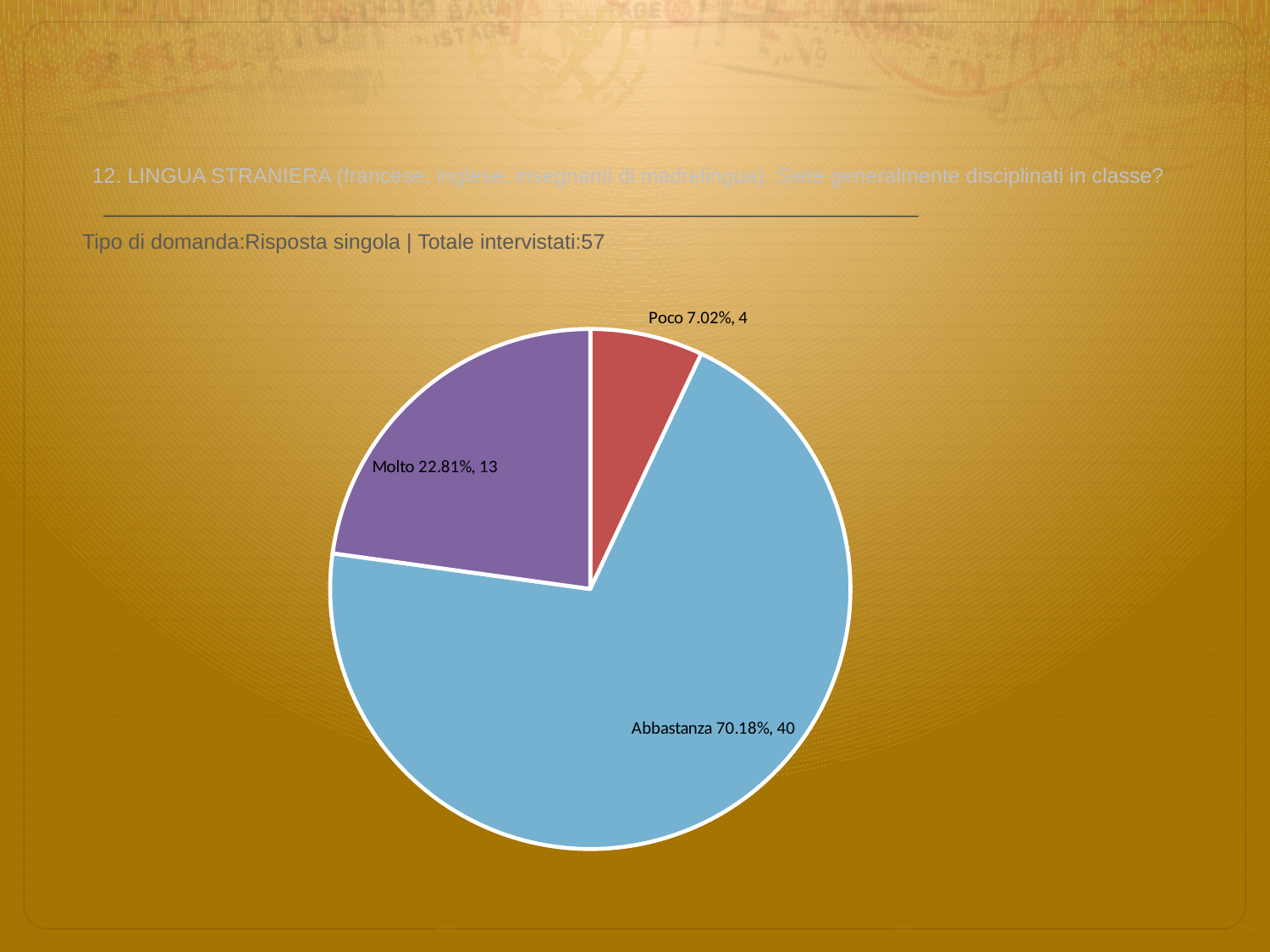
How many slices does the pie chart have? 3 How many respondents answered Abbastanza? 40 What is the difference in respondent count between Abbastanza and Molto? 27 How many respondents answered Molto? 13 Which has more respondents, Molto or Poco? Molto What percentage share does the Molto slice have? 22.81% Which category has the smallest slice? Poco Which category has the largest slice? Abbastanza How many respondents answered Poco? 4 What kind of chart is shown on the slide? pie chart What percentage share does the Poco slice have? 7.02% What percentage share does the Abbastanza slice have? 70.18%